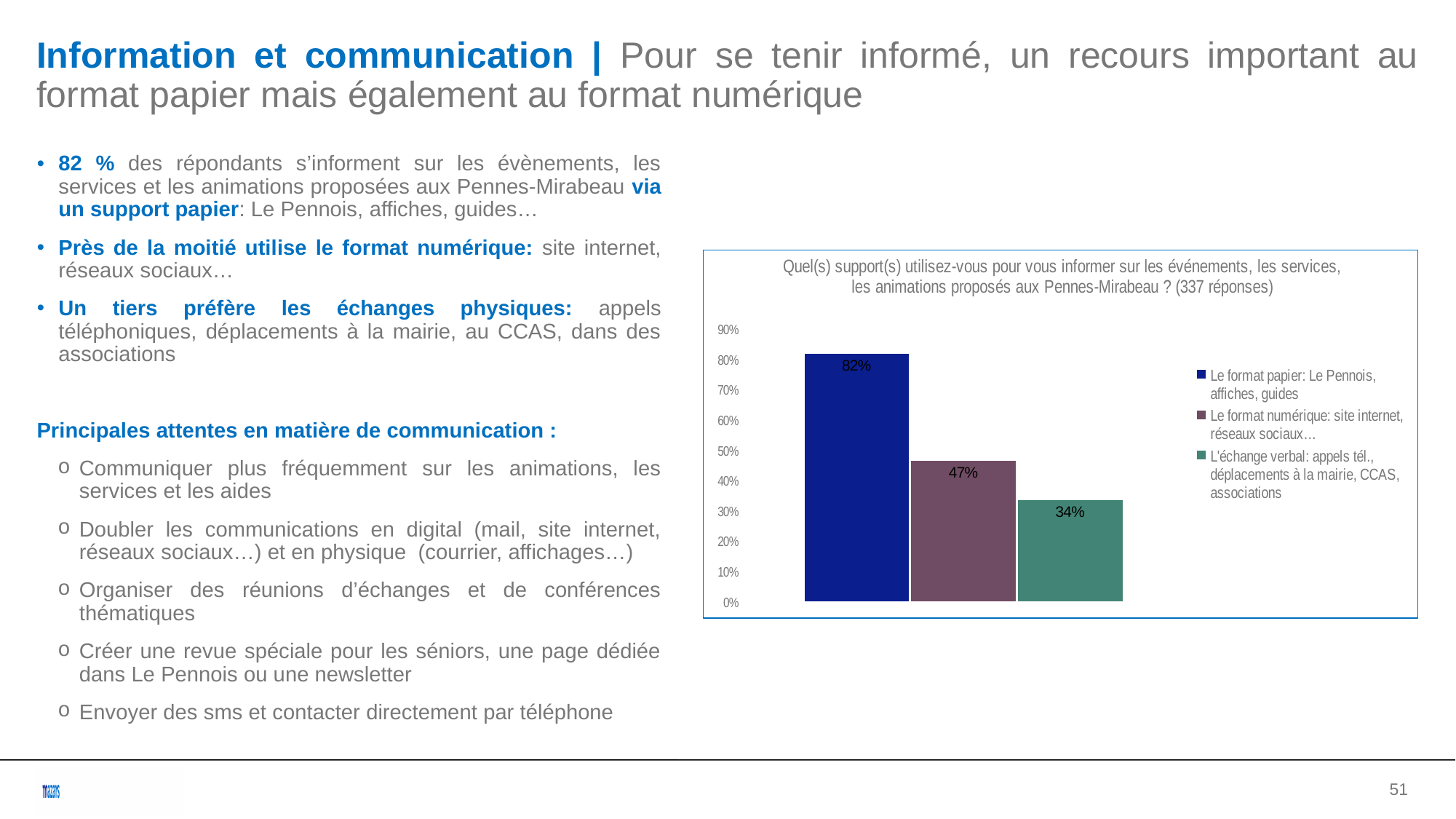
Is the value for the paper format greater or less than 80%? greater What is the difference in percentage points between the digital format and verbal exchange? 13 Which is larger: the share for the digital format or the share for verbal exchange? Le format numérique: site internet, réseaux sociaux… What kind of chart is shown on the slide? Bar chart What percentage of respondents use the paper format (Le Pennois, affiches, guides) to stay informed? 82% How many series does the legend list? 3 How many responses does the chart title say the survey question received? 337 réponses What percentage of respondents use the digital format (site internet, réseaux sociaux)? 47% What percentage of respondents use verbal exchange (appels tél., déplacements à la mairie, CCAS, associations)? 34% Which support has the lowest share of respondents? L'échange verbal: appels tél., déplacements à la mairie, CCAS, associations Which support has the highest share of respondents? Le format papier: Le Pennois, affiches, guides What is the difference in percentage points between the paper format and the digital format? 35